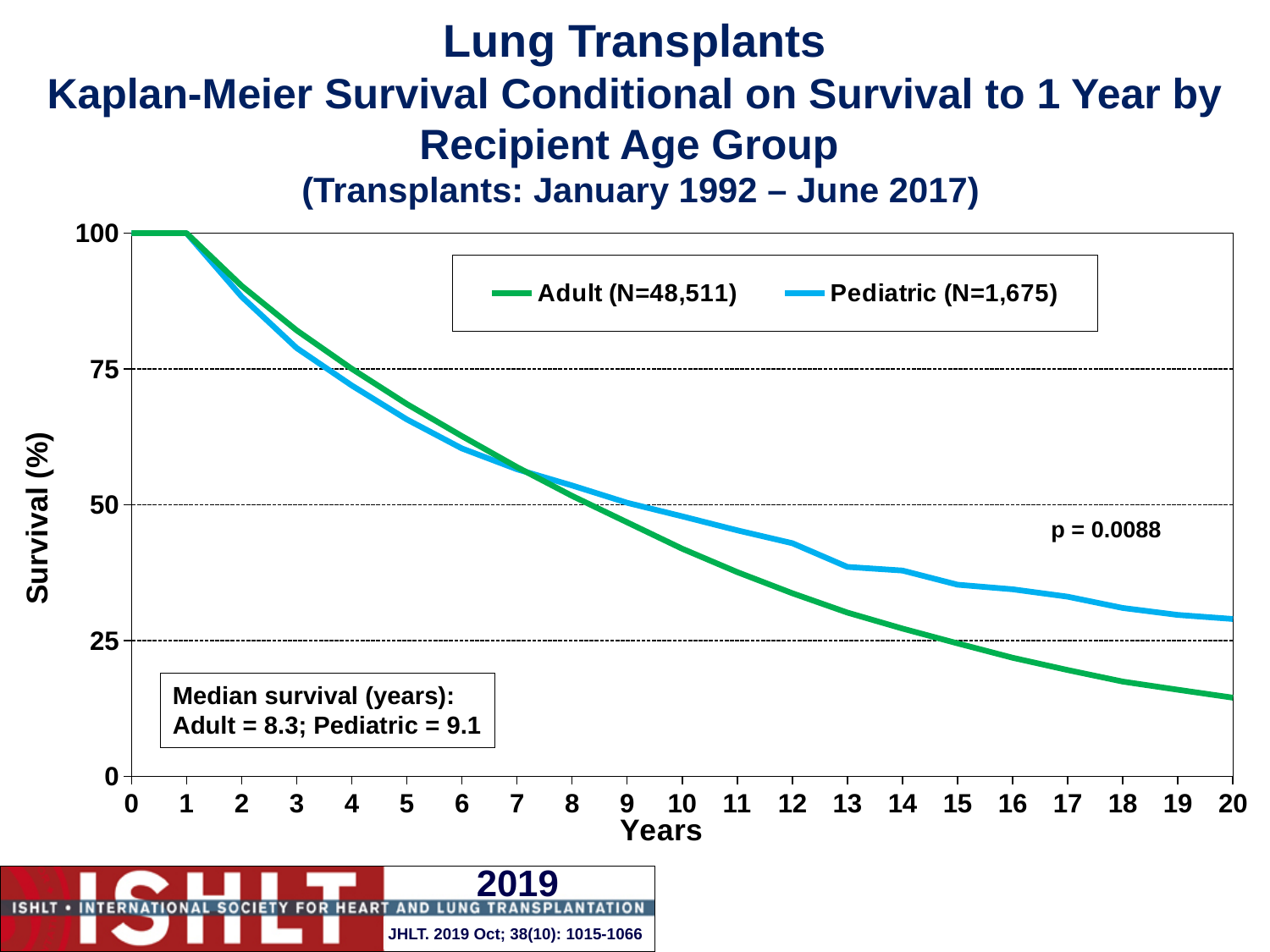
Do the survival curves rise or fall as years increase? Fall Which group has the higher median survival, Adult or Pediatric? Pediatric Is the Adult survival value at 20 years greater or less than 25? less What is the median survival in years for the Pediatric group? 9.1 What p-value is shown on the chart? p = 0.0088 What kind of chart is shown on the slide? Line chart Is the Pediatric survival value at 15 years greater or less than 25? greater What is the N for the Pediatric group shown in the legend? 1,675 How many series does the legend list? 2 What is the N for the Adult group shown in the legend? 48,511 What are the two series named in the legend? Adult (N=48,511) and Pediatric (N=1,675) What is the median survival in years for the Adult group? 8.3